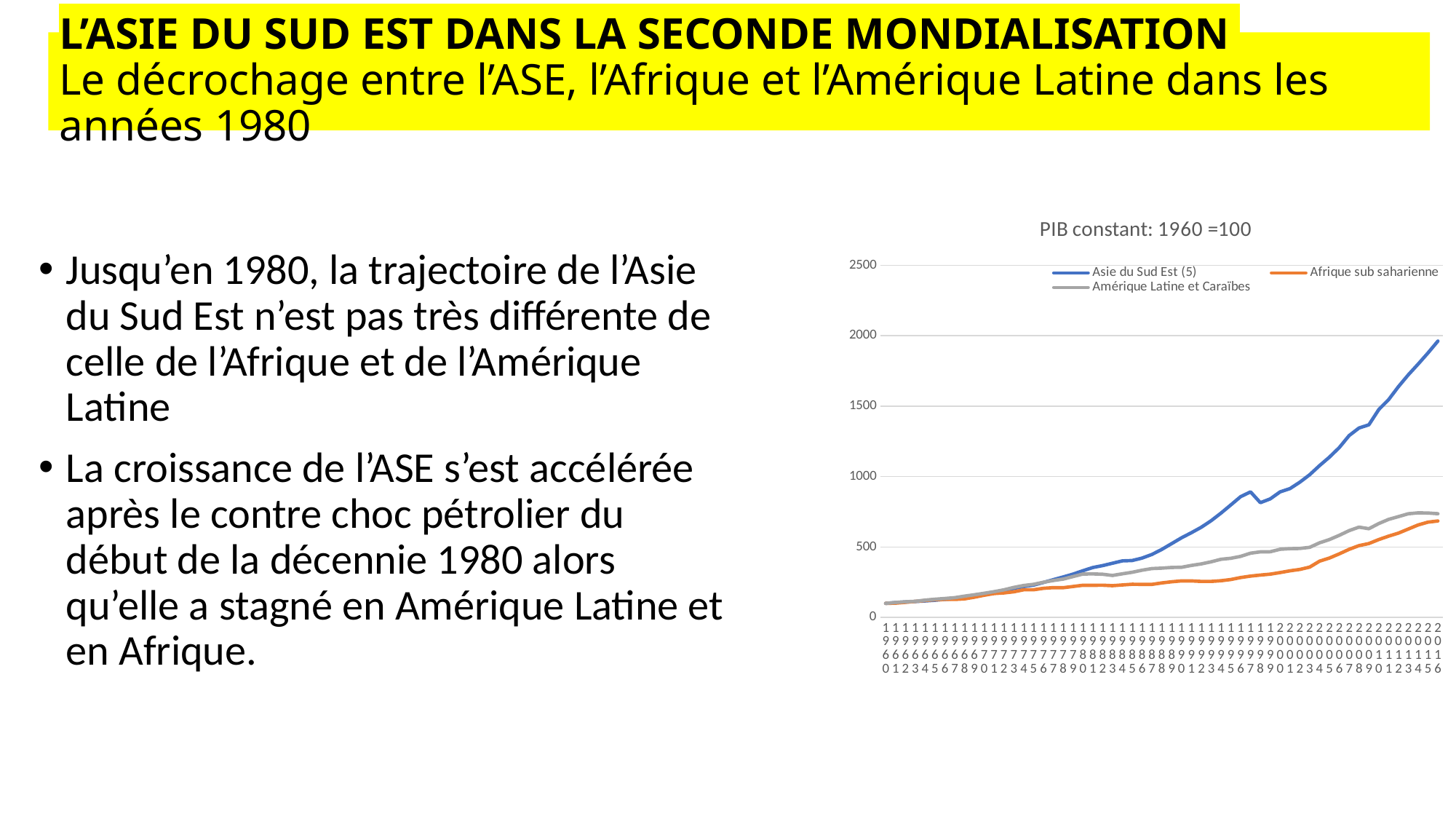
Which series has the lowest value at the end of the chart (2016)? Afrique sub saharienne Which series has the highest value at the end of the chart (2016)? Asie du Sud Est (5) In 2010, which is larger: the value for Amérique Latine et Caraïbes or the value for Afrique sub saharienne? Amérique Latine et Caraïbes What is the title of the chart? PIB constant: 1960 =100 What kind of chart is shown on the slide? line chart How many series does the chart's legend list? 3 What is the first year shown on the x axis of the chart? 1960 Is the value for Asie du Sud Est (5) in 2016 greater or less than 1500? greater Which series is drawn in blue on the chart? Asie du Sud Est (5) Is the value for Afrique sub saharienne in 2016 greater or less than 1000? less Is the value for Amérique Latine et Caraïbes in 2016 greater or less than 500? greater Does the Asie du Sud Est (5) series rise or fall overall from 1960 to 2016? rise